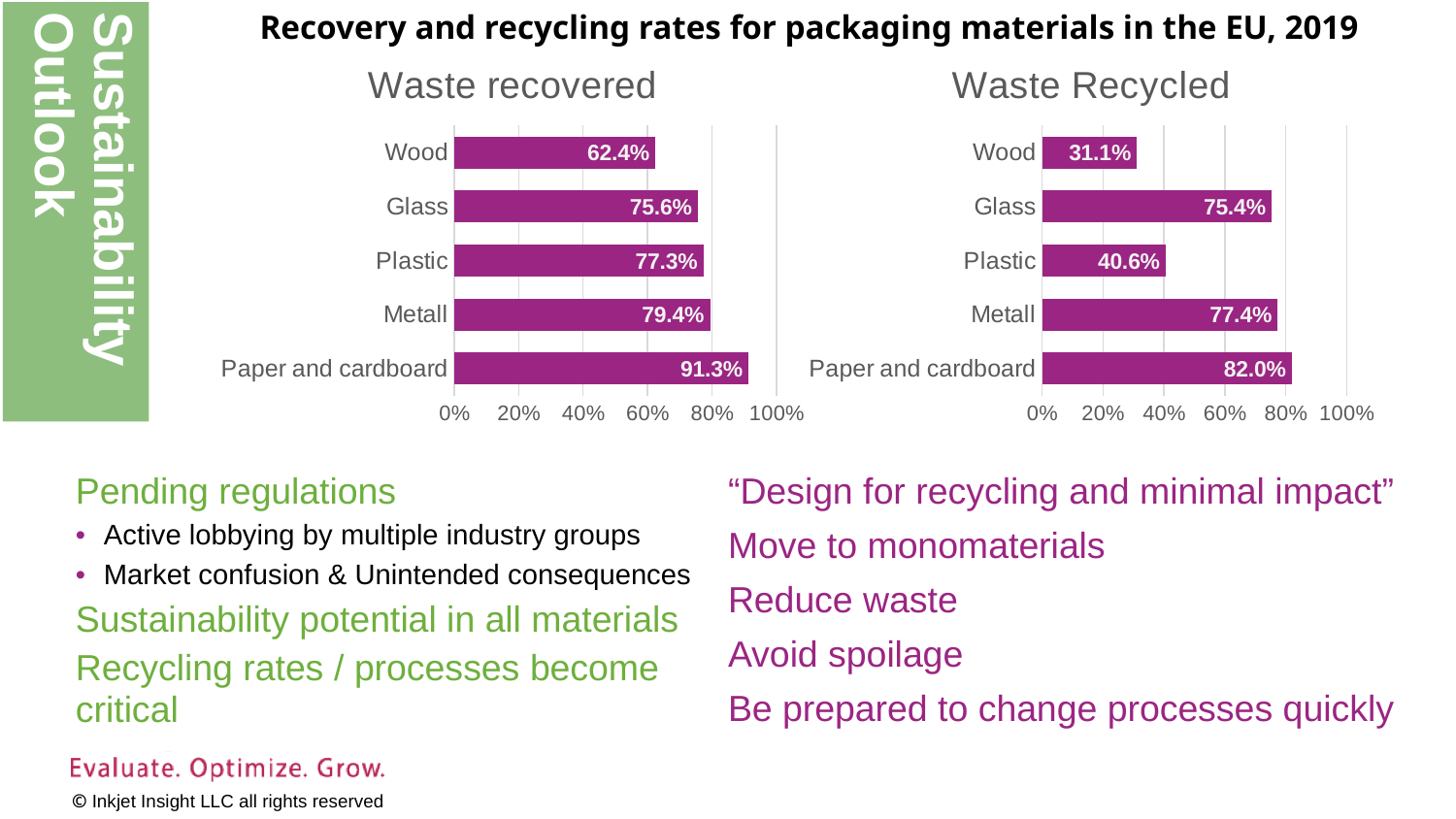
How many categories are shown in the Waste recovered chart? 5 In the Waste recovered chart, is the value for Glass greater or less than 80%? less In the Waste Recycled chart, which is larger, Metall or Glass? Metall In the Waste recovered chart, what is the difference between Paper and cardboard and Wood? 28.9% In the Waste Recycled chart, which category has the lowest value? Wood In the Waste Recycled chart, what is the value for Paper and cardboard? 82.0% In the Waste recovered chart, which category has the highest value? Paper and cardboard What kind of chart is the Waste Recycled chart? bar chart In the Waste recovered chart, what is the value for Wood? 62.4% In the Waste Recycled chart, what is the difference between Glass and Plastic? 34.8% What is the title printed above the two charts? Recovery and recycling rates for packaging materials in the EU, 2019 In the Waste Recycled chart, what is the value for Plastic? 40.6%